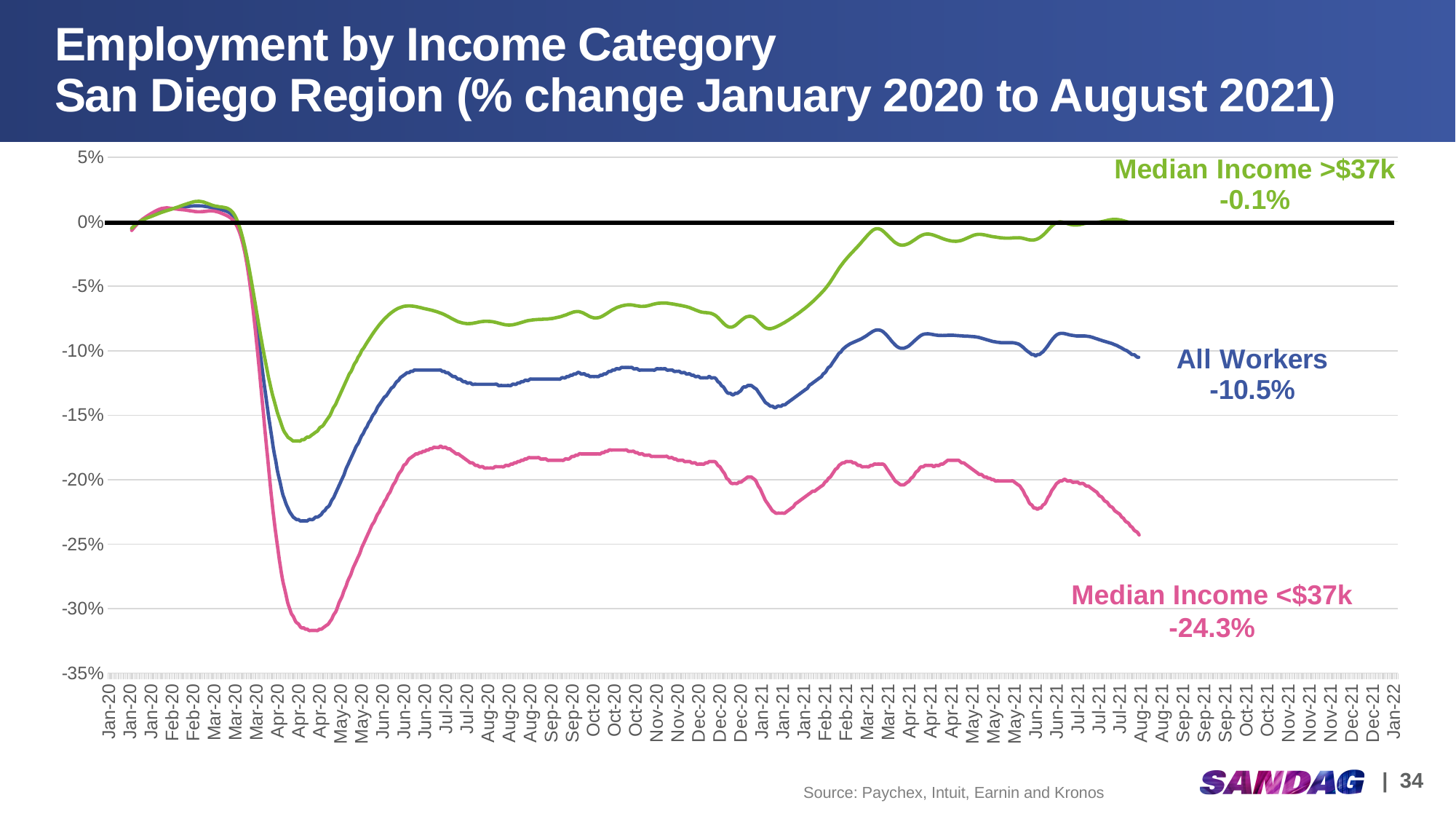
What kind of chart is shown on the slide? Line chart Which series has the highest labelled end value? Median Income >$37k Which has a higher labelled end value, All Workers or Median Income <$37k? All Workers How many series are plotted on the chart? 3 What is the labelled value for Median Income <$37k at the end of the series? -24.3% What is the difference in percentage points between the labelled end values for Median Income >$37k and Median Income <$37k? 24.2 percentage points Which series has the lowest labelled end value? Median Income <$37k What is the labelled value for All Workers at the end of the series? -10.5% What is the difference in percentage points between the labelled end values for All Workers and Median Income <$37k? 13.8 percentage points What is the labelled value for Median Income >$37k at the end of the series? -0.1% At its lowest point in April 2020, is the value for All Workers greater or less than -20%? less At its lowest point in April 2020, is the value for Median Income <$37k greater or less than -30%? less